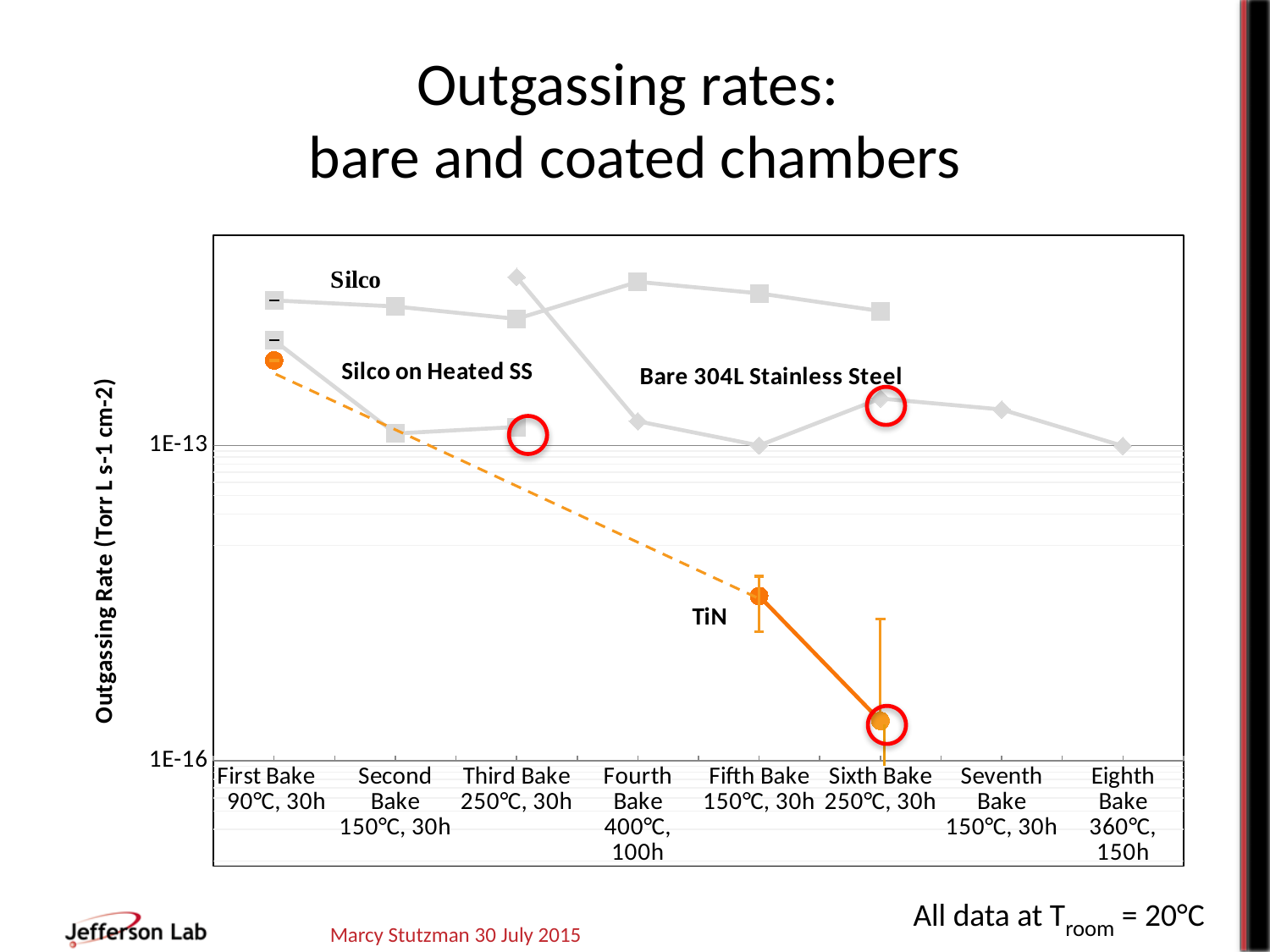
Does the TiN series rise or fall from First Bake to Sixth Bake? fall What type of chart is shown on the slide? line chart Which series has the lowest value at Sixth Bake? TiN How many data series are labeled on the chart? 4 Is the TiN value at Sixth Bake greater or less than 1E-13? less How many bake steps are listed along the x axis? 8 At which bake does the TiN series reach its lowest value? Sixth Bake What is the label of the y axis? Outgassing Rate (Torr L s-1 cm-2) At Fifth Bake, which series has the higher value, Silco or TiN? Silco At First Bake, which is higher, Silco or Silco on Heated SS? Silco Is the TiN value at Fifth Bake greater or less than 1E-13? less Is the Silco value at First Bake greater or less than 1E-13? greater